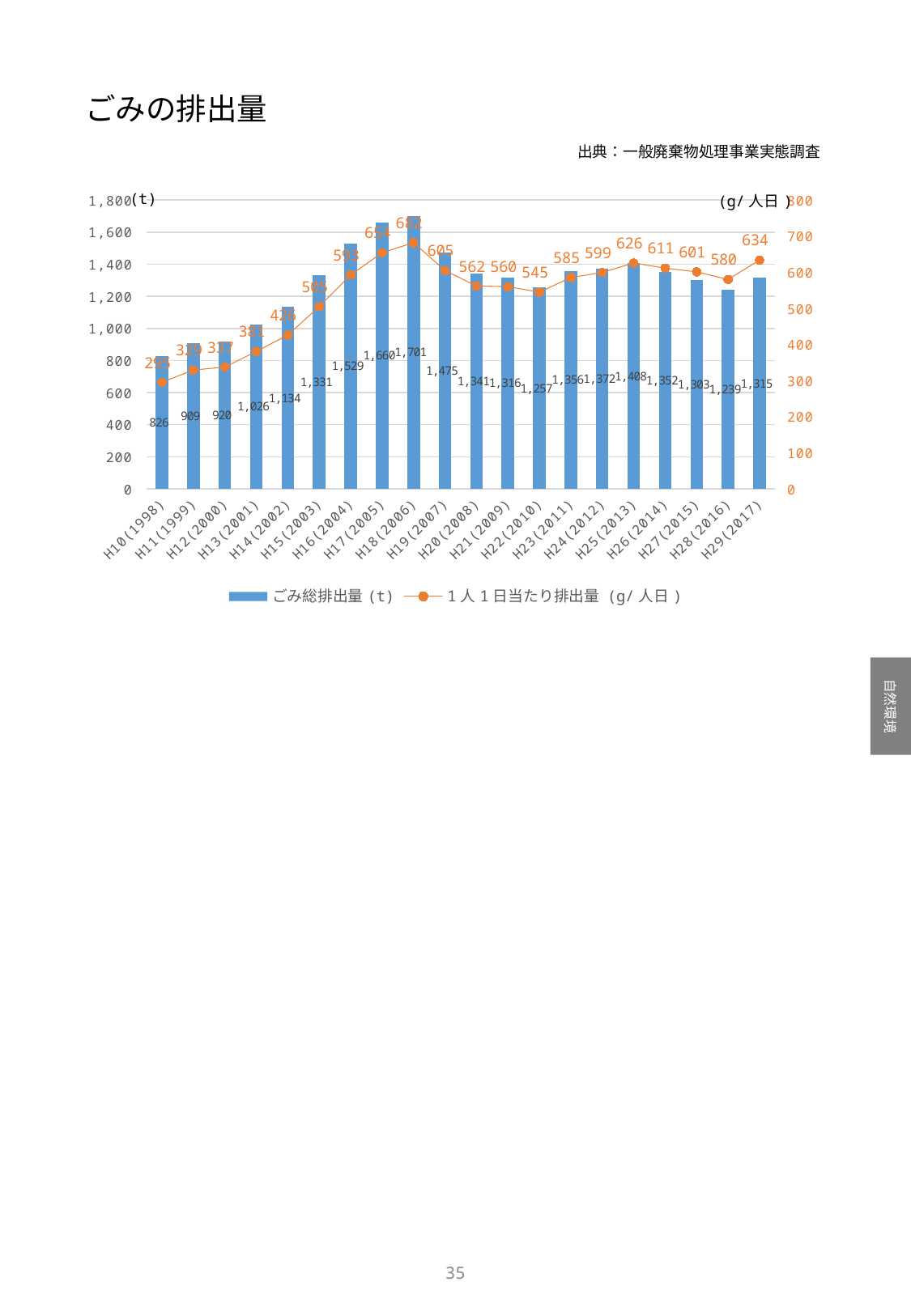
What is the ごみ総排出量 (t) value for H18(2006)? 1,701 Which year has the lowest ごみ総排出量 (t)? H10(1998) What kind of chart is shown on the slide? Combined bar and line chart What is the title of the chart? ごみの排出量 How many series does the legend list? 2 Which year has the highest ごみ総排出量 (t)? H18(2006) What is the ごみ総排出量 (t) value for H10(1998)? 826 Which year has the highest 1人1日当たり排出量 (g/人日)? H18(2006) What is the 1人1日当たり排出量 (g/人日) value for H29(2017)? 634 What is the difference in ごみ総排出量 (t) between H18(2006) and H29(2017)? 386 Which is larger, the ごみ総排出量 (t) for H25(2013) or for H26(2014)? H25(2013) How many years are shown on the x axis? 20